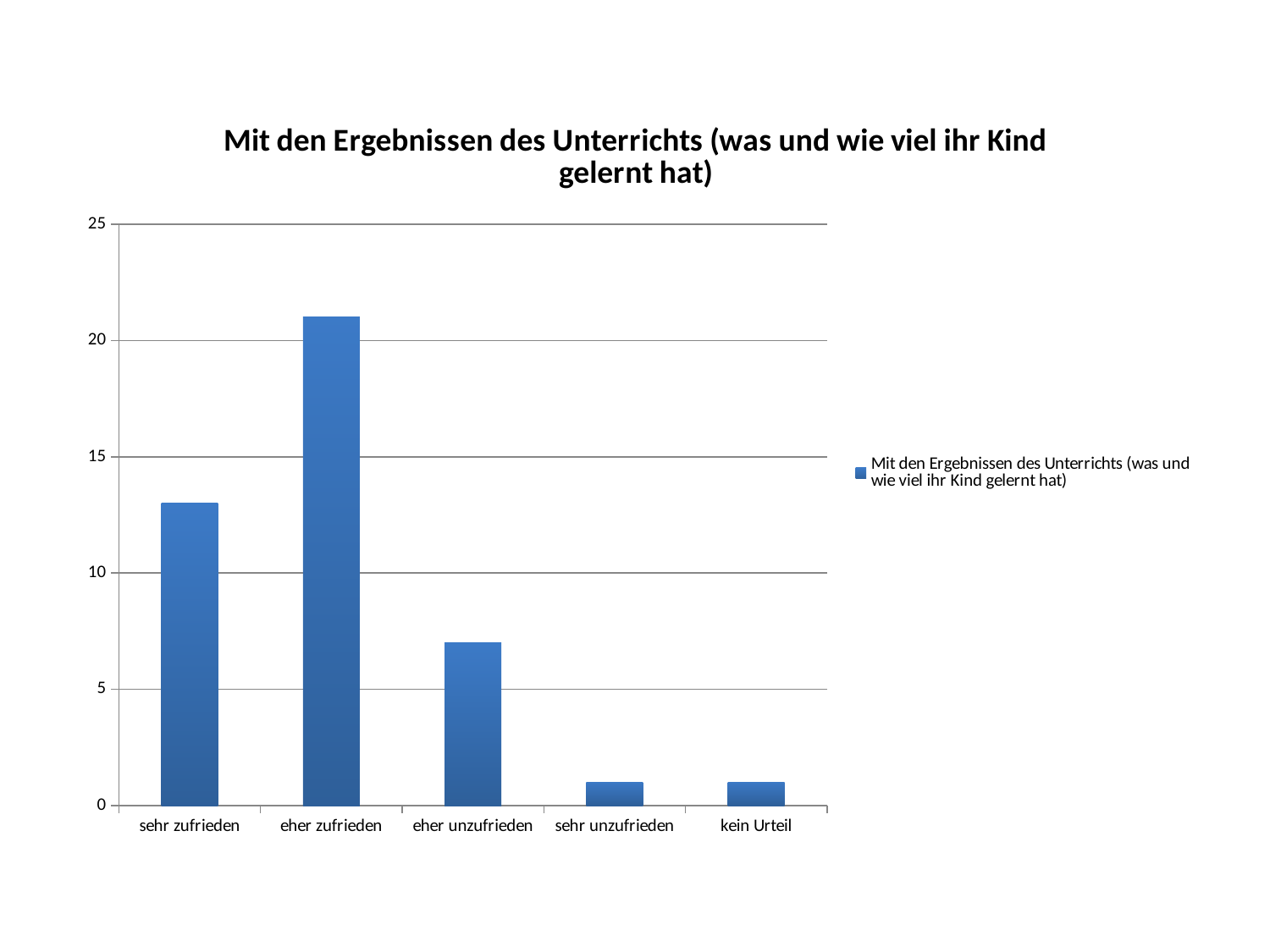
Is the value for eher unzufrieden greater or less than 10? less How many series does the legend list? 1 How many categories are shown on the x axis? 5 Is the value for eher zufrieden greater or less than 20? greater Is the value for kein Urteil greater or less than 5? less Which is larger, the value for sehr zufrieden or the value for eher unzufrieden? sehr zufrieden Which is larger, the value for eher zufrieden or the value for sehr unzufrieden? eher zufrieden Which category has the highest value? eher zufrieden What is the title of the chart? Mit den Ergebnissen des Unterrichts (was und wie viel ihr Kind gelernt hat) What kind of chart is shown on the slide? bar chart